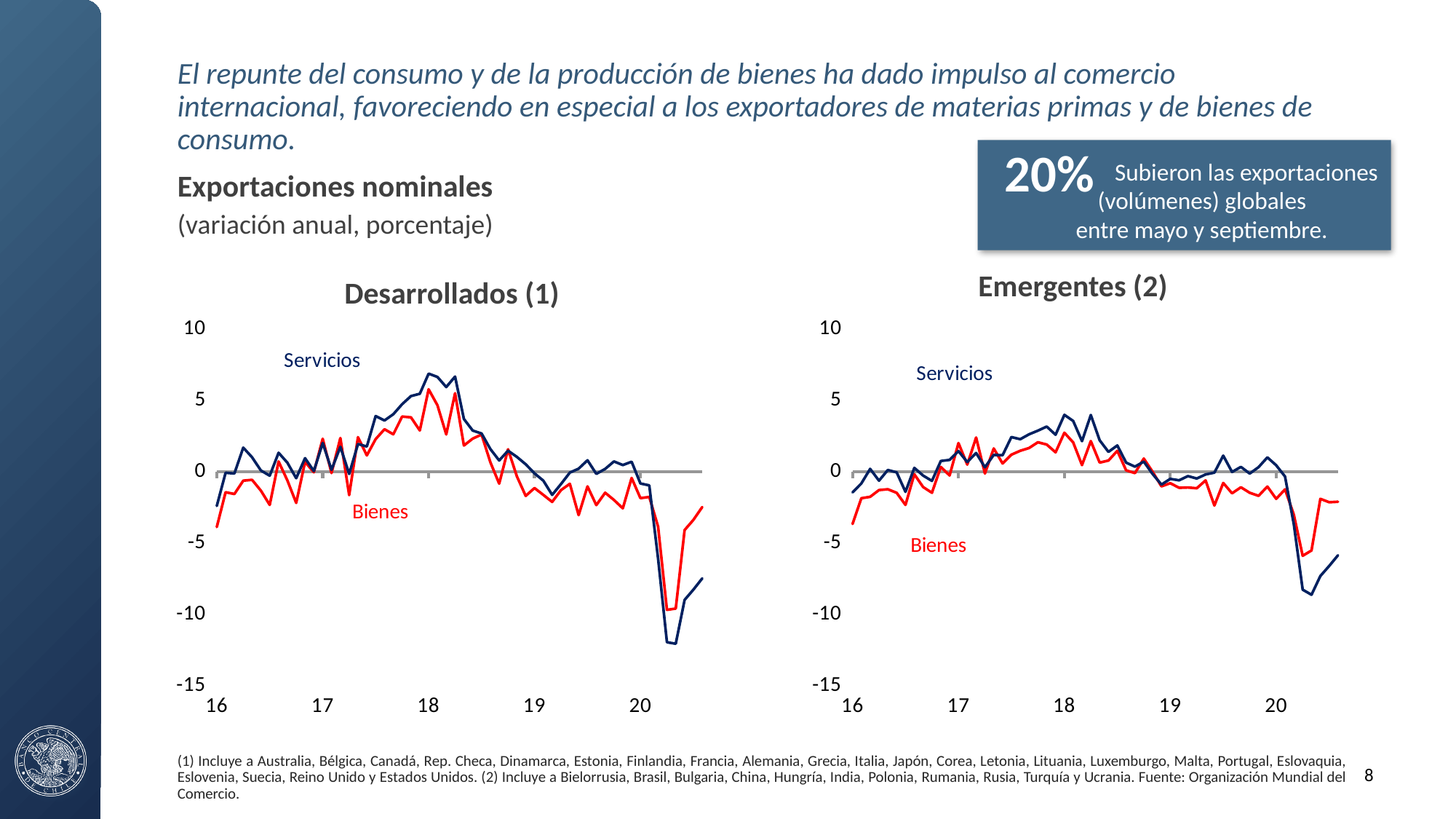
What kind of chart is the 'Desarrollados (1)' chart? line chart On the 'Emergentes (2)' chart, which colour is the Bienes line? red On the 'Emergentes (2)' chart, is the highest value of the Servicios line around 2018 greater or less than 5? less On the 'Desarrollados (1)' chart, which series falls to a lower value in 2020, Servicios or Bienes? Servicios How many year labels are shown on the x axis of the 'Emergentes (2)' chart? 5 On the 'Emergentes (2)' chart, which series falls to a lower value in 2020, Servicios or Bienes? Servicios On the 'Desarrollados (1)' chart, what are the names of the two series plotted? Servicios and Bienes On the 'Emergentes (2)' chart, is the lowest value of the Servicios line in 2020 greater or less than -5? less On the 'Desarrollados (1)' chart, do the Servicios values rise or fall between 2018 and 2020? fall How many series are plotted on the 'Emergentes (2)' chart? 2 On the 'Desarrollados (1)' chart, is the highest value of the Servicios line around 2018 greater or less than 5? greater